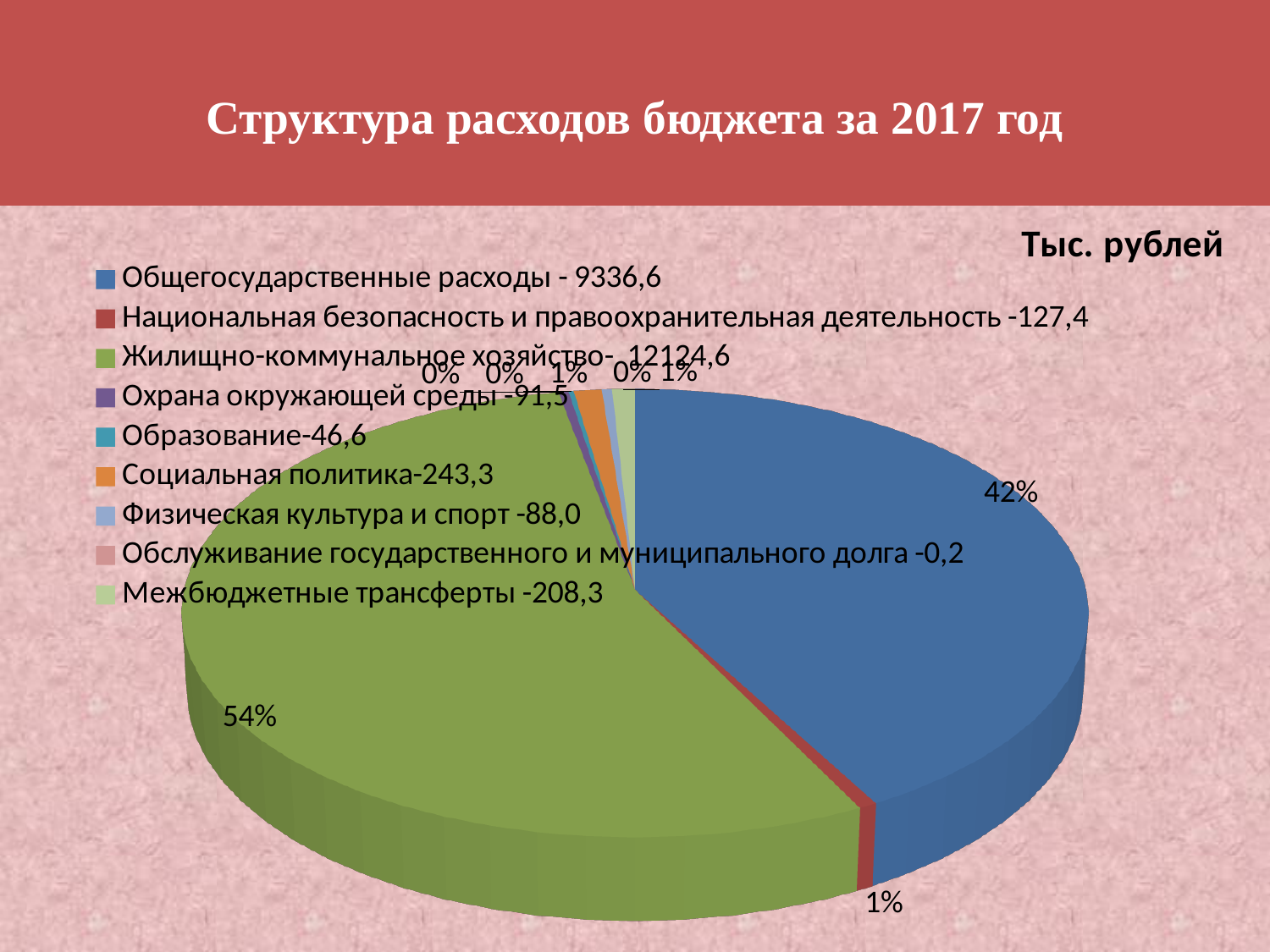
Which category has the largest share of the pie? Жилищно-коммунальное хозяйство What is the value for Социальная политика shown in the legend? 243,3 What is the difference between the values for Жилищно-коммунальное хозяйство and Общегосударственные расходы? 2788,0 What share of the pie does Общегосударственные расходы take? 42% How many categories does the legend of the pie chart list? 9 What is the title of the chart? Структура расходов бюджета за 2017 год What is the value for Образование shown in the legend? 46,6 Which is larger: the value for Межбюджетные трансферты or the value for Национальная безопасность и правоохранительная деятельность? Межбюджетные трансферты What kind of chart is shown on the slide? Pie chart In what units are the values on the slide given? Тыс. рублей Which category has the smallest value according to the legend? Обслуживание государственного и муниципального долга What share of the pie does Жилищно-коммунальное хозяйство take? 54%